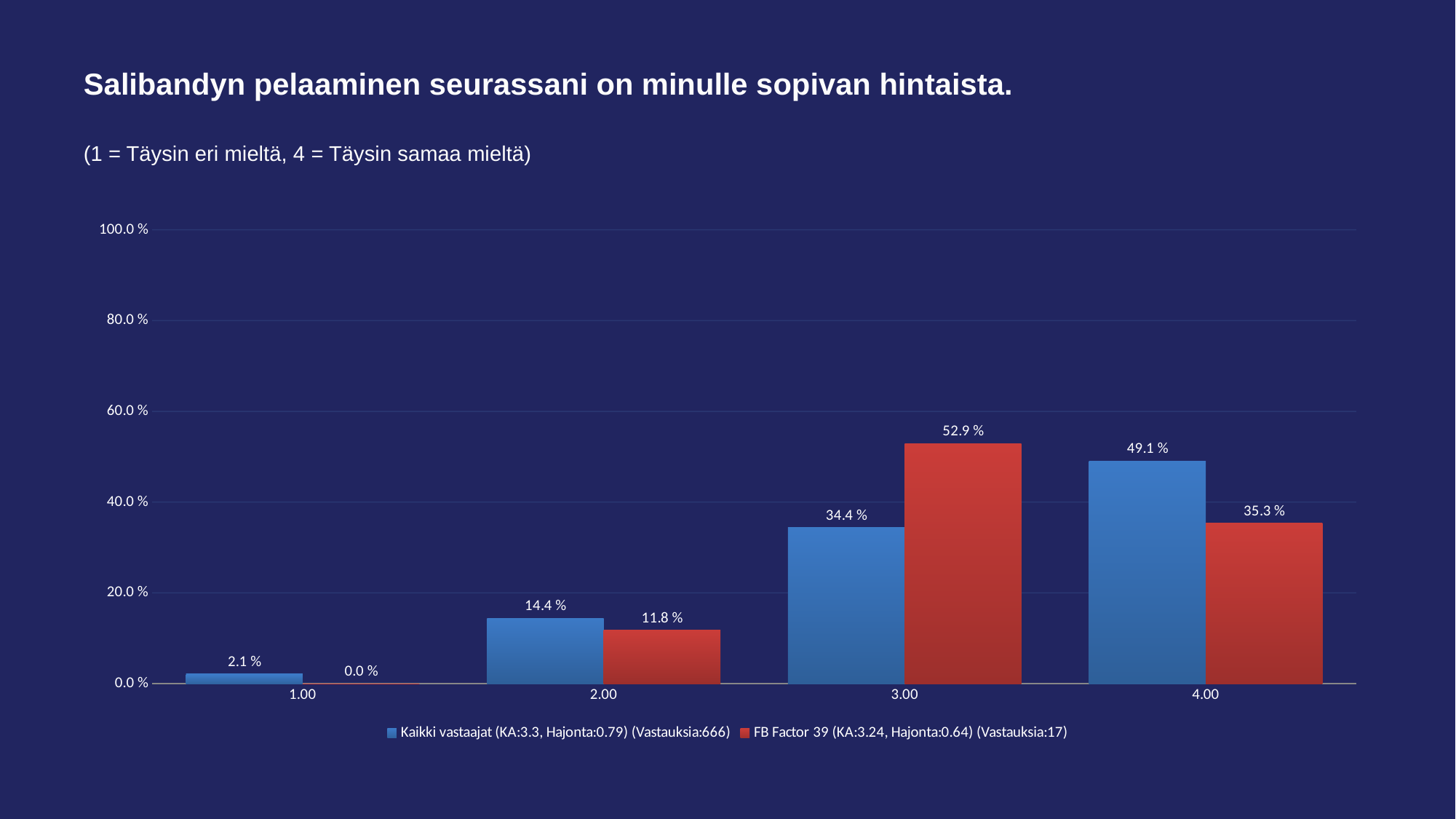
What is the difference between the FB Factor 39 value and the Kaikki vastaajat value at category 3.00? 18.5 % How many categories are shown on the x axis? 4 Is the value for FB Factor 39 at category 3.00 greater or less than 40.0 %? greater Which category has the highest value for FB Factor 39? 3.00 What is the value for Kaikki vastaajat at category 3.00? 34.4 % Which category has the lowest value for Kaikki vastaajat? 1.00 What is the value for FB Factor 39 at category 4.00? 35.3 % How many series does the legend list? 2 What is the value for FB Factor 39 at category 1.00? 0.0 % At category 2.00, which series has the larger value, Kaikki vastaajat or FB Factor 39? Kaikki vastaajat What kind of chart is shown on the slide? Bar chart Which category has the highest value for Kaikki vastaajat? 4.00